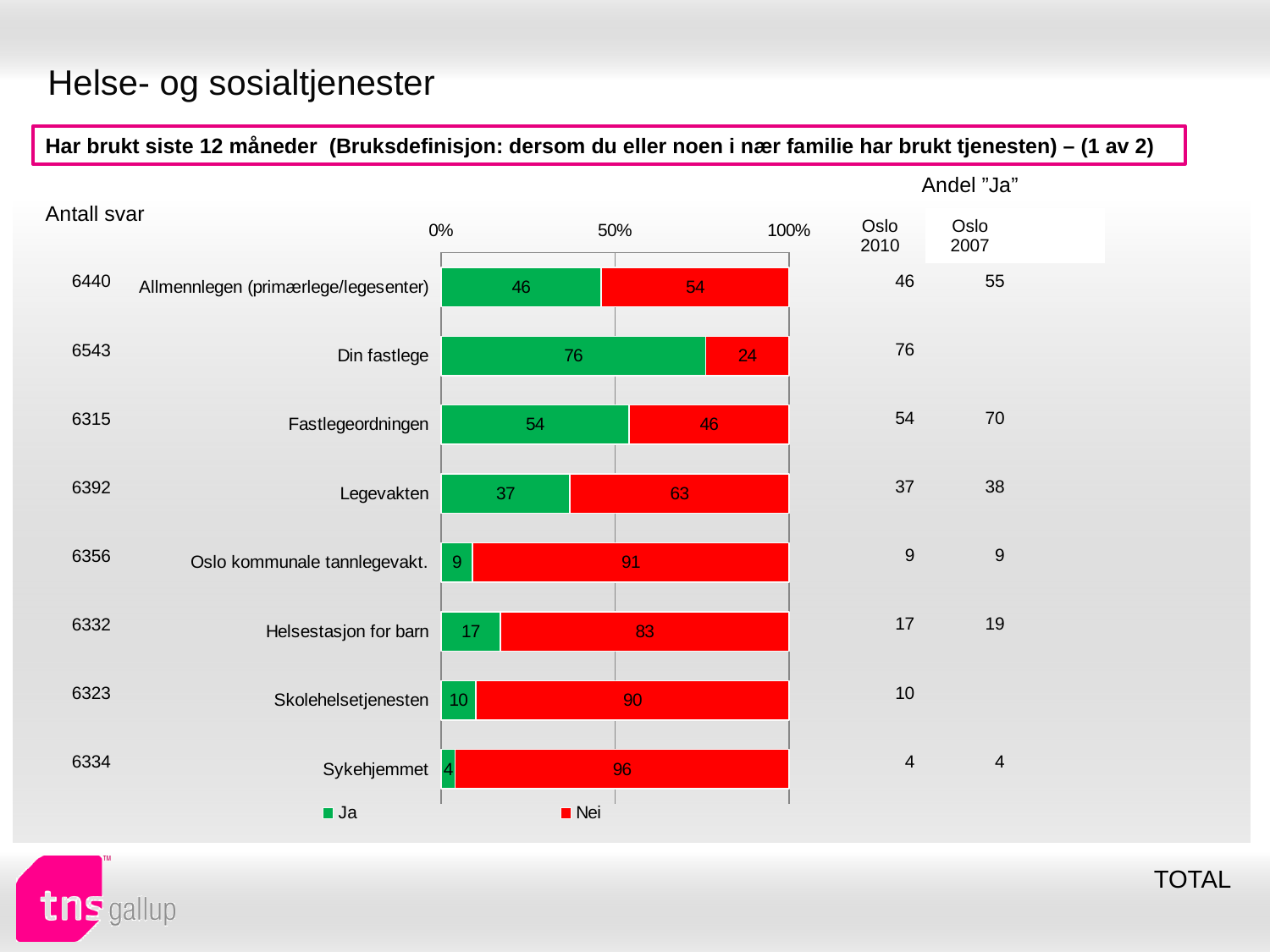
What is the "Nei" value for Legevakten? 63 Which is larger: the "Ja" value for Allmennlegen (primærlege/legesenter) or the "Ja" value for Legevakten? Allmennlegen (primærlege/legesenter) What is the total of the stacked bar for Skolehelsetjenesten? 100 What is the difference between the "Ja" and "Nei" values for Fastlegeordningen? 8 How many series does the legend list? 2 Which category has the lowest "Ja" value? Sykehjemmet Which colour represents the "Nei" series in the chart? Red What is the "Ja" value for Helsestasjon for barn? 17 What kind of chart is shown on the slide? Stacked bar chart What is the "Ja" value for Din fastlege? 76 How many categories are shown in the chart? 8 Which category has the highest "Ja" value? Din fastlege